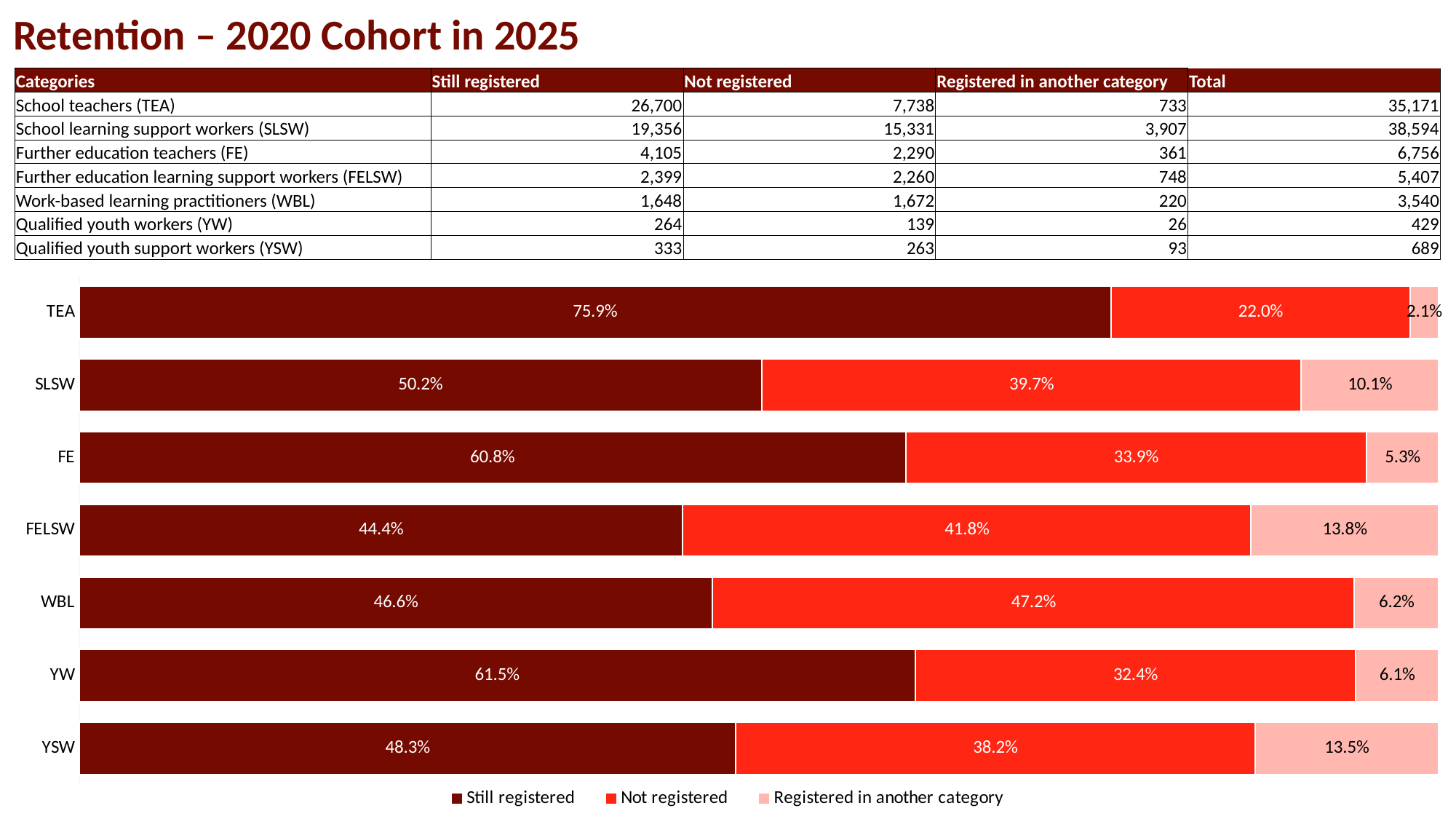
For WBL, which is larger in the chart: the Still registered share or the Not registered share? Not registered What is the Not registered share for WBL in the chart? 47.2% How many categories are shown in the chart? 7 What is the difference between the Still registered shares of TEA and SLSW in the chart? 25.7 percentage points What kind of chart is shown on the slide? Stacked bar chart How many series does the chart legend list? 3 Which series is shown in the darkest colour in the chart legend? Still registered What is the Registered in another category share for FELSW in the chart? 13.8% Which category has the lowest Not registered share in the chart? TEA What is the Still registered share for TEA in the chart? 75.9% Which category has the highest Still registered share in the chart? TEA Which category has the lowest Still registered share in the chart? FELSW